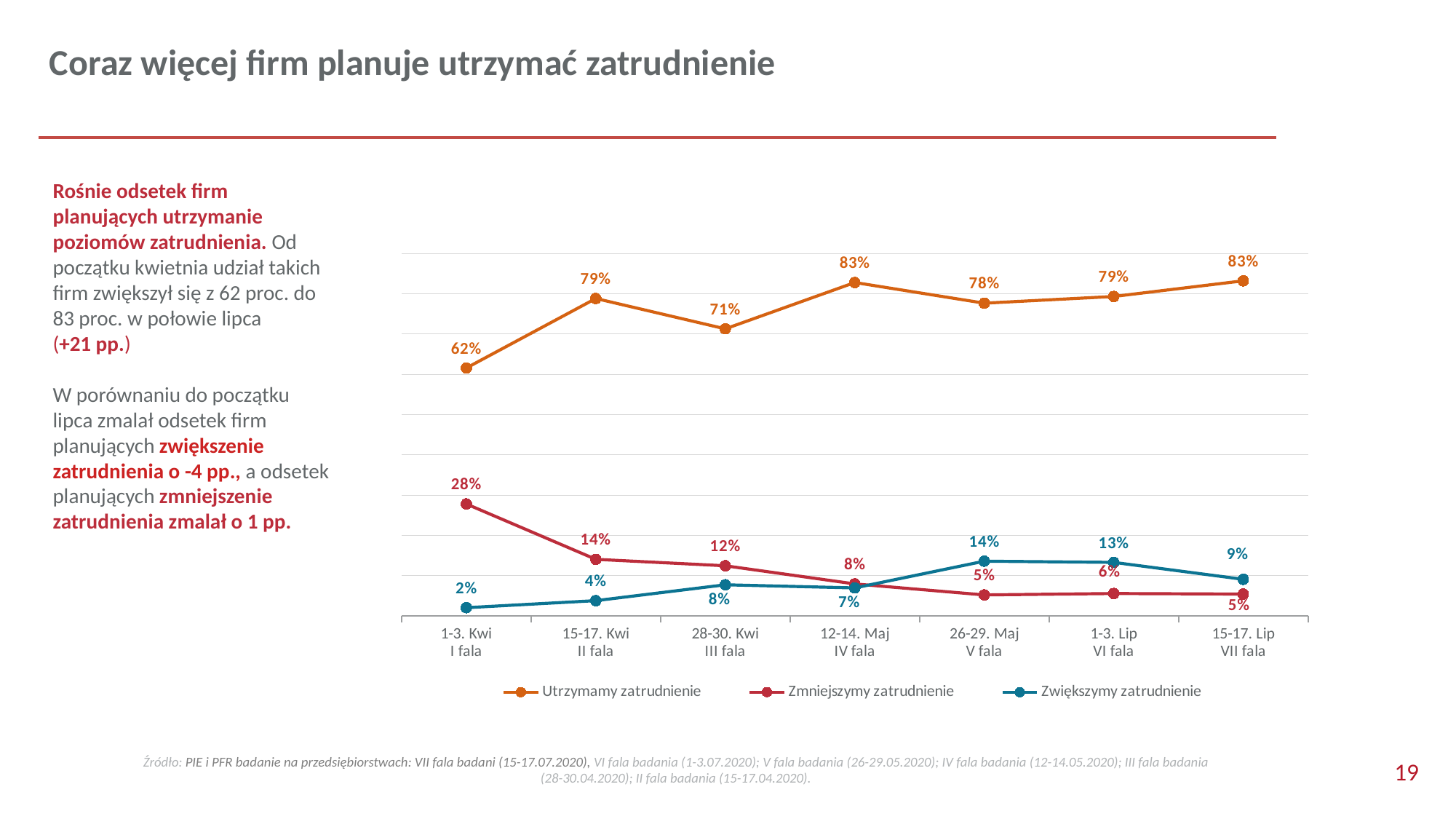
Which colour is used for the 'Utrzymamy zatrudnienie' series? orange In which wave is the 'Zwiększymy zatrudnienie' series at its highest? V fala (26-29. Maj) How many survey waves (data points) are plotted along the x axis? 7 What type of chart is shown on the slide? line chart Does the 'Zmniejszymy zatrudnienie' series generally rise or fall from I fala to VII fala? fall What is the value for 'Zmniejszymy zatrudnienie' in III fala (28-30. Kwi)? 12% What is the difference between the 'Utrzymamy zatrudnienie' values in VII fala and I fala? 21 percentage points Which is larger in VII fala (15-17. Lip): 'Zwiększymy zatrudnienie' or 'Zmniejszymy zatrudnienie'? Zwiększymy zatrudnienie How many series does the legend list? 3 In which wave is the 'Utrzymamy zatrudnienie' series at its lowest? I fala (1-3. Kwi) What is the value for 'Utrzymamy zatrudnienie' in I fala (1-3. Kwi)? 62% What is the value for 'Zwiększymy zatrudnienie' in VI fala (1-3. Lip)? 13%